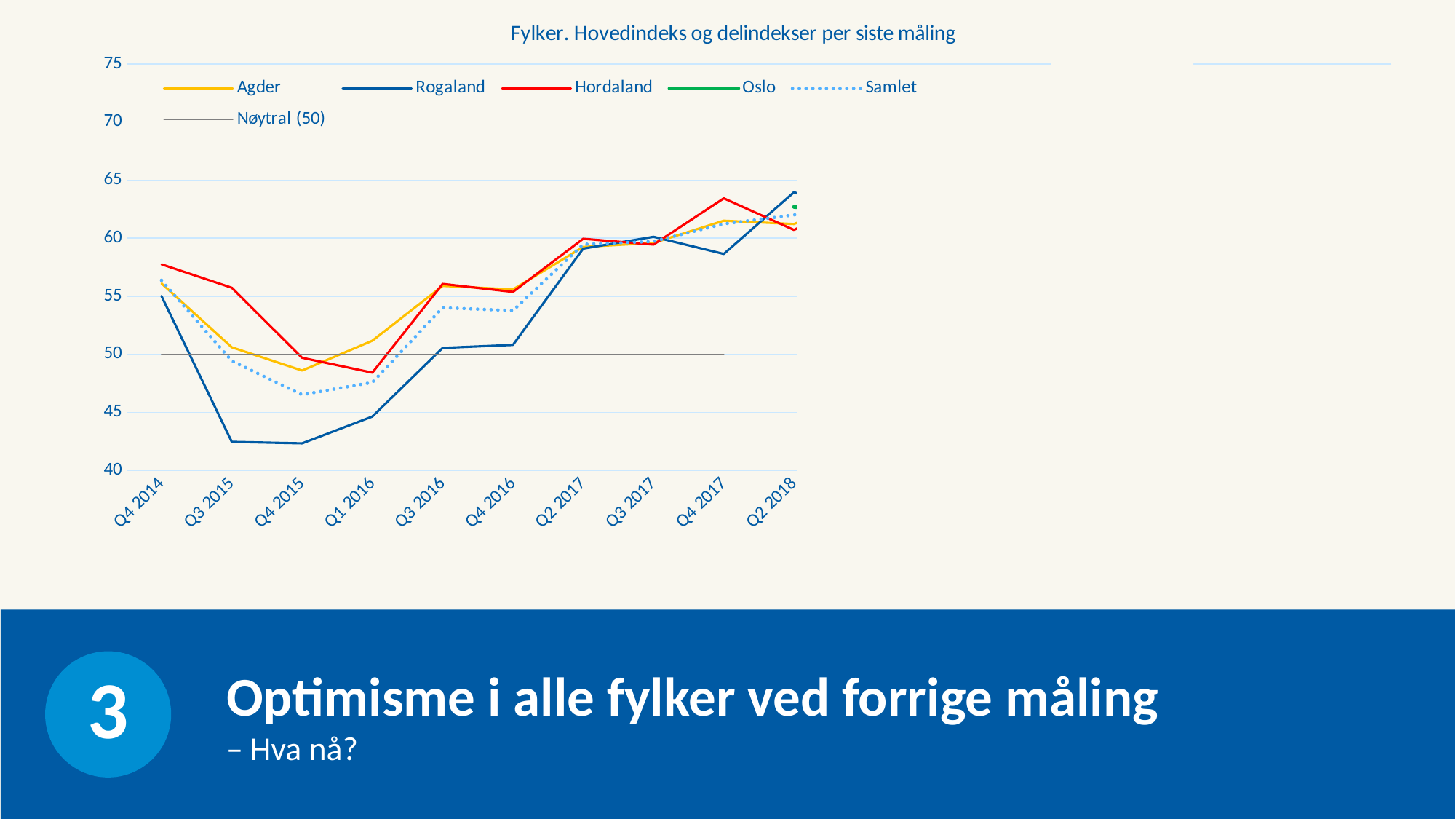
Is the value for Rogaland at Q3 2015 greater or less than 45? less How many time points are shown on the x axis? 10 Which series has the lowest value at Q3 2015? Rogaland What kind of chart is shown on the slide? line chart Is the value for Rogaland at Q2 2018 greater or less than 60? greater How many series does the legend list? 6 Is the value for Samlet at Q4 2015 greater or less than 50? less Which series has the highest value at Q4 2017? Hordaland At Q4 2014, which is larger: Rogaland or Hordaland? Hordaland Does the Rogaland line rise or fall from Q4 2015 to Q2 2017? rise What is the title of the chart? Fylker. Hovedindeks og delindekser per siste måling